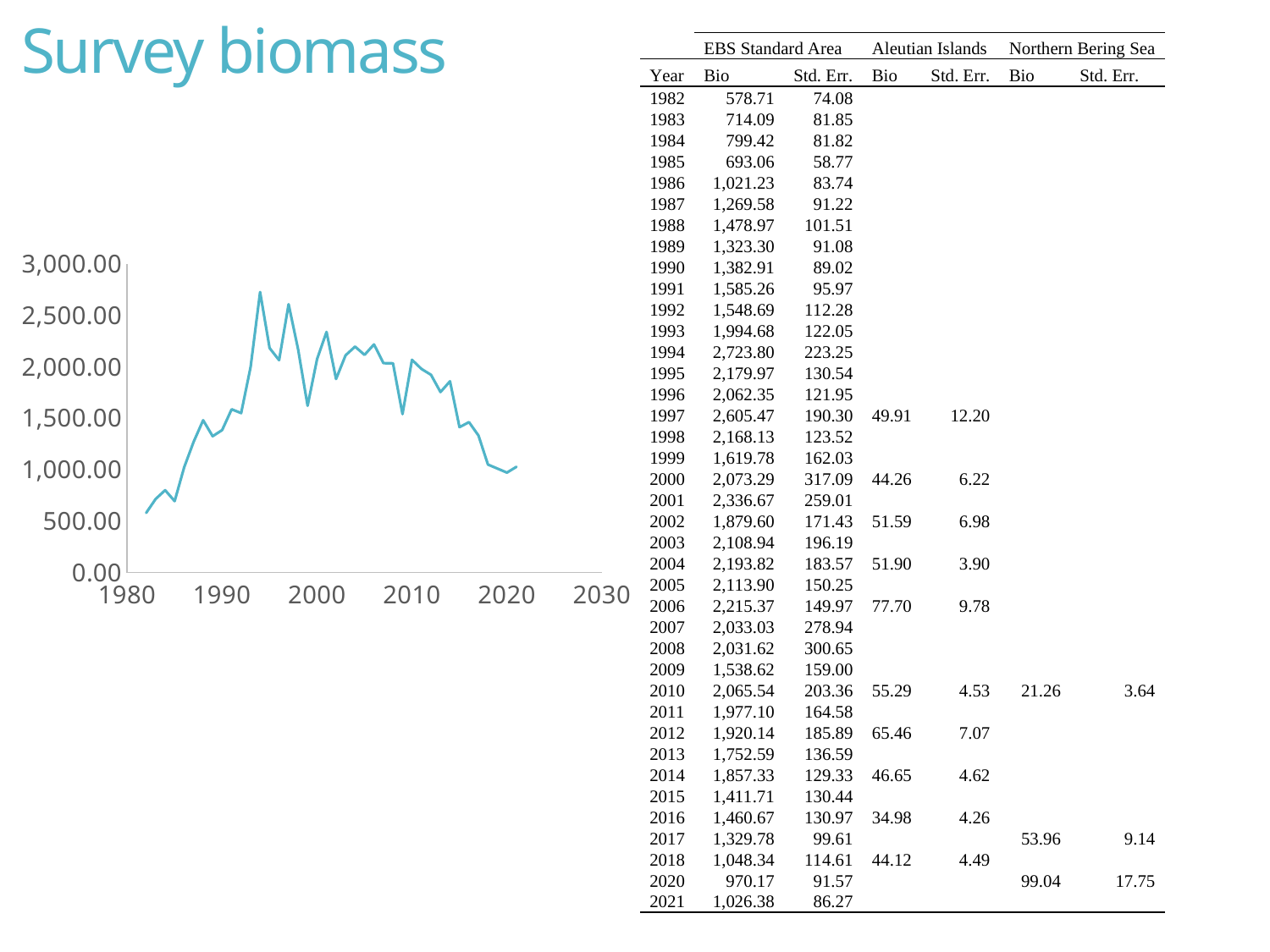
Is the value plotted for 1985 greater or less than 1,000? less Does the line rise or fall between 2010 and 2020? fall What kind of chart is shown on the slide? line chart Is the value plotted for 2015 greater or less than 1,500? less Is the value plotted for 2006 greater or less than 2,000? greater In which year does the line on the chart reach its highest point? 1994 Does the line rise or fall between 1982 and 1994? rise What is the title of the slide containing the chart? Survey biomass According to the table on the slide, what is the EBS Standard Area Bio value for 1994? 2,723.80 According to the table on the slide, what is the EBS Standard Area Bio value for 2021? 1,026.38 What is the highest value shown on the chart's y axis? 3,000.00